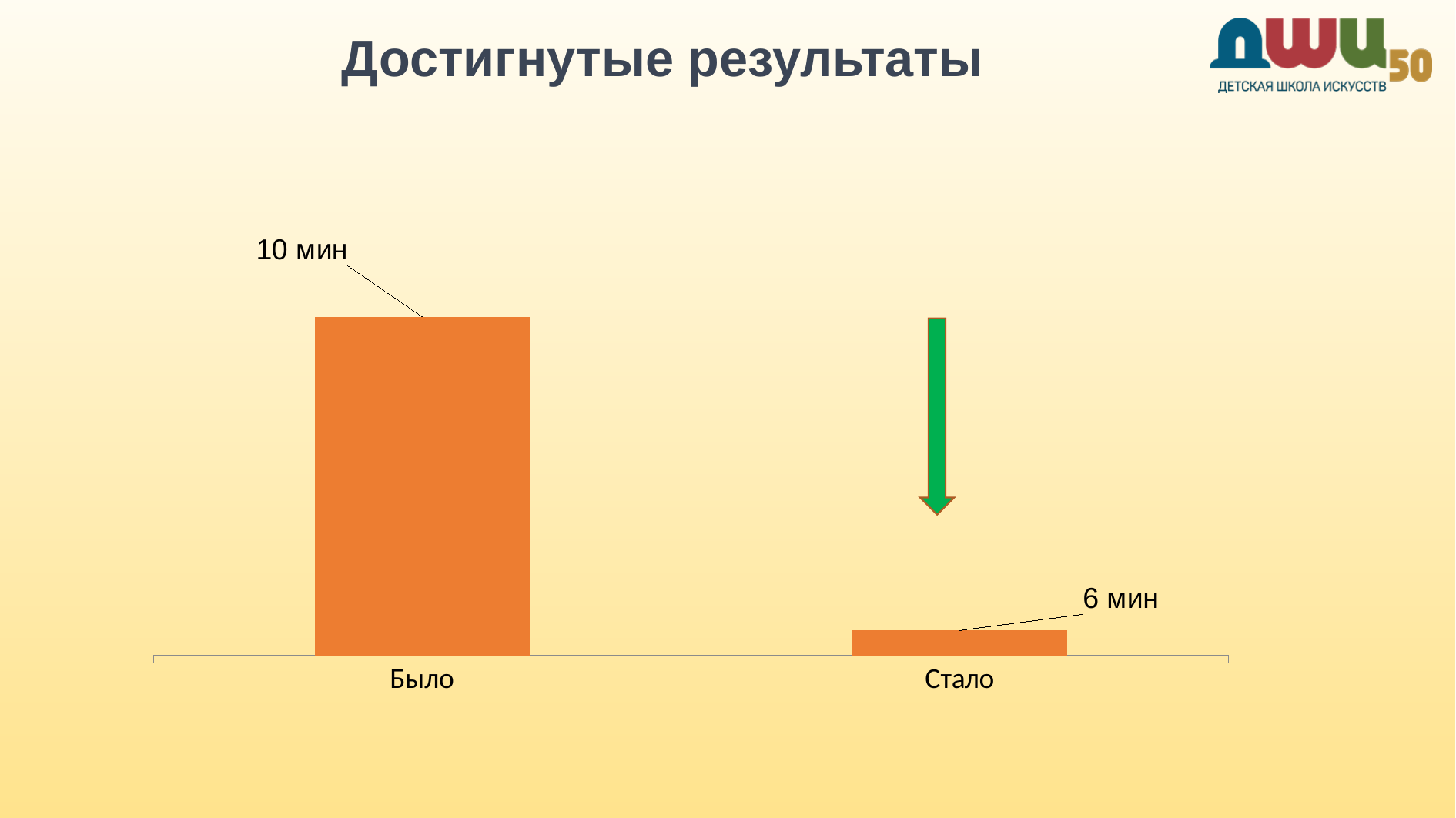
What type of chart is shown on the slide? Bar chart Which category has the higher value, "Было" or "Стало"? Было Do the values rise or fall from "Было" to "Стало"? Fall Which category has the highest value in the chart? Было How many categories are shown on the x axis of the chart? 2 What colour are the bars in the chart? Orange What value is shown for the "Стало" bar? 6 мин What is the difference between the "Было" and "Стало" values? 4 мин What value is shown for the "Было" bar? 10 мин What is the title of the slide containing the chart? Достигнутые результаты Which category has the lowest value in the chart? Стало